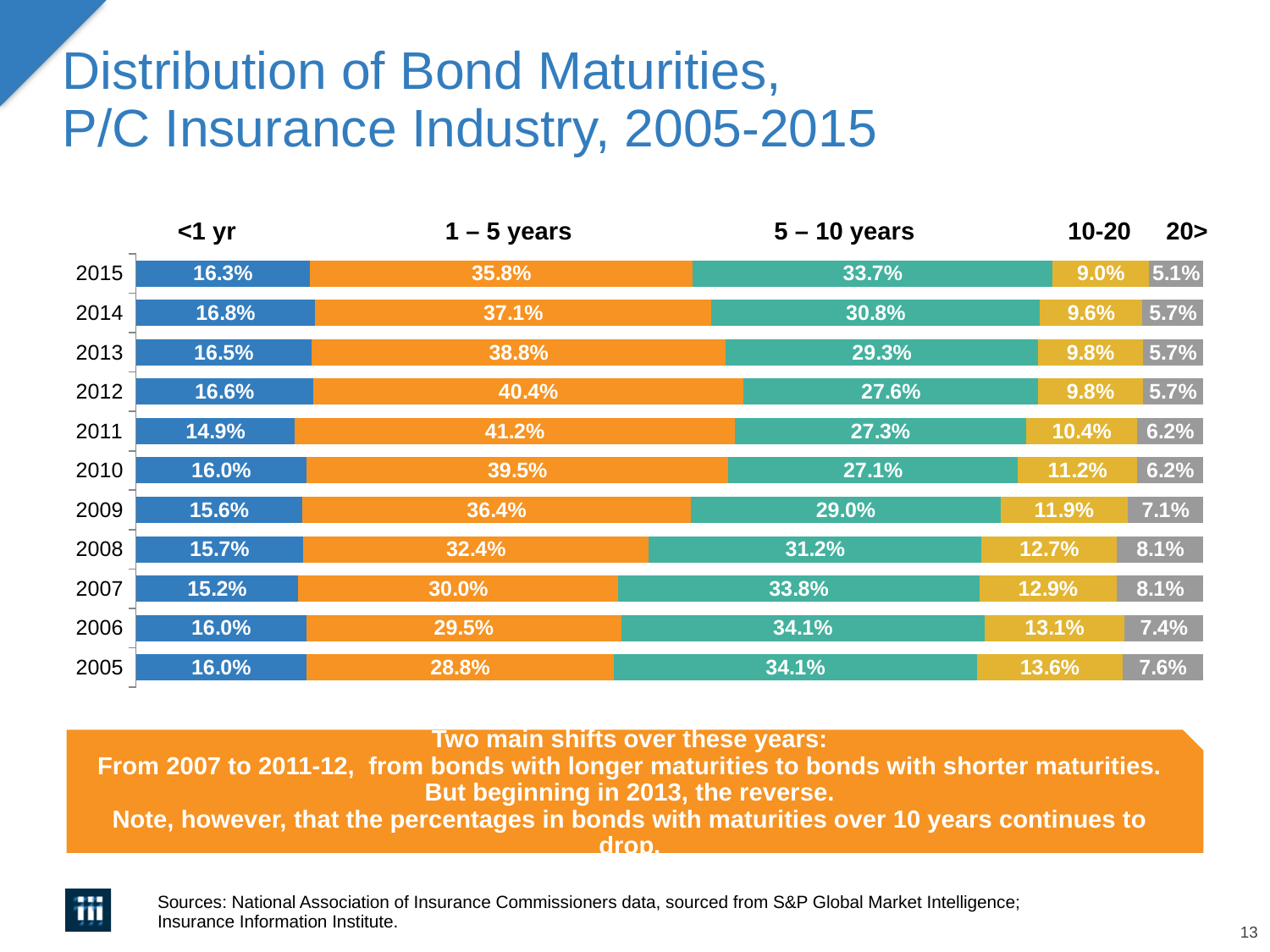
How many years are shown in the chart? 11 What was the share of bonds with 5 – 10 year maturities in 2005? 34.1% In which year was the share of bonds with 1 – 5 year maturities the highest? 2011 How many maturity categories does the chart show? 5 How much larger was the 1 – 5 years share in 2012 than in 2005? 11.6 percentage points What percentage of bonds had a maturity of 1 – 5 years in 2015? 35.8% Did the share of bonds with 10-20 year maturities rise or fall from 2005 to 2015? Fall In which year was the share of bonds with maturities under 1 year the lowest? 2011 Which year had a larger share of bonds with 5 – 10 year maturities, 2008 or 2014? 2008 What type of chart is shown on the slide? Stacked bar chart Which year had the highest share of bonds with 10-20 year maturities? 2005 What percentage of bonds had a maturity of less than 1 year in 2011? 14.9%